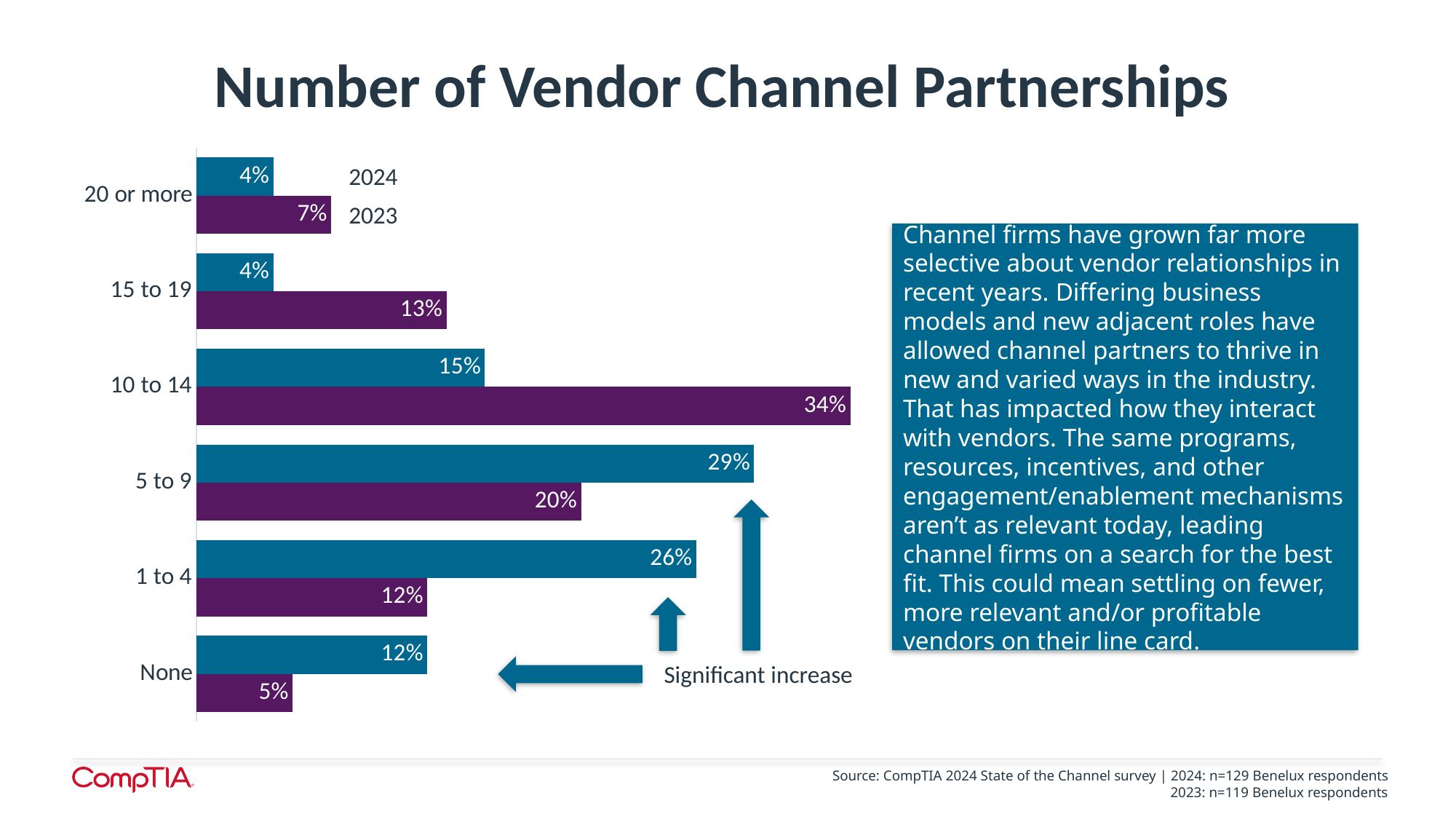
Which category has the highest 2024 value? 5 to 9 Which category has the highest 2023 value? 10 to 14 What type of chart is shown on the slide? Bar chart Which category has the lowest 2023 value? None What is the difference between the 2023 and 2024 values for '10 to 14'? 19% What is the 2023 value for the '5 to 9' category? 20% How many categories are shown on the chart? 6 How many series does the chart show? 2 For '15 to 19', which year has the larger value, 2023 or 2024? 2023 What is the difference between the 2024 and 2023 values for '1 to 4'? 14% What is the 2024 value for 'None'? 12% What is the 2024 value for the '10 to 14' category? 15%